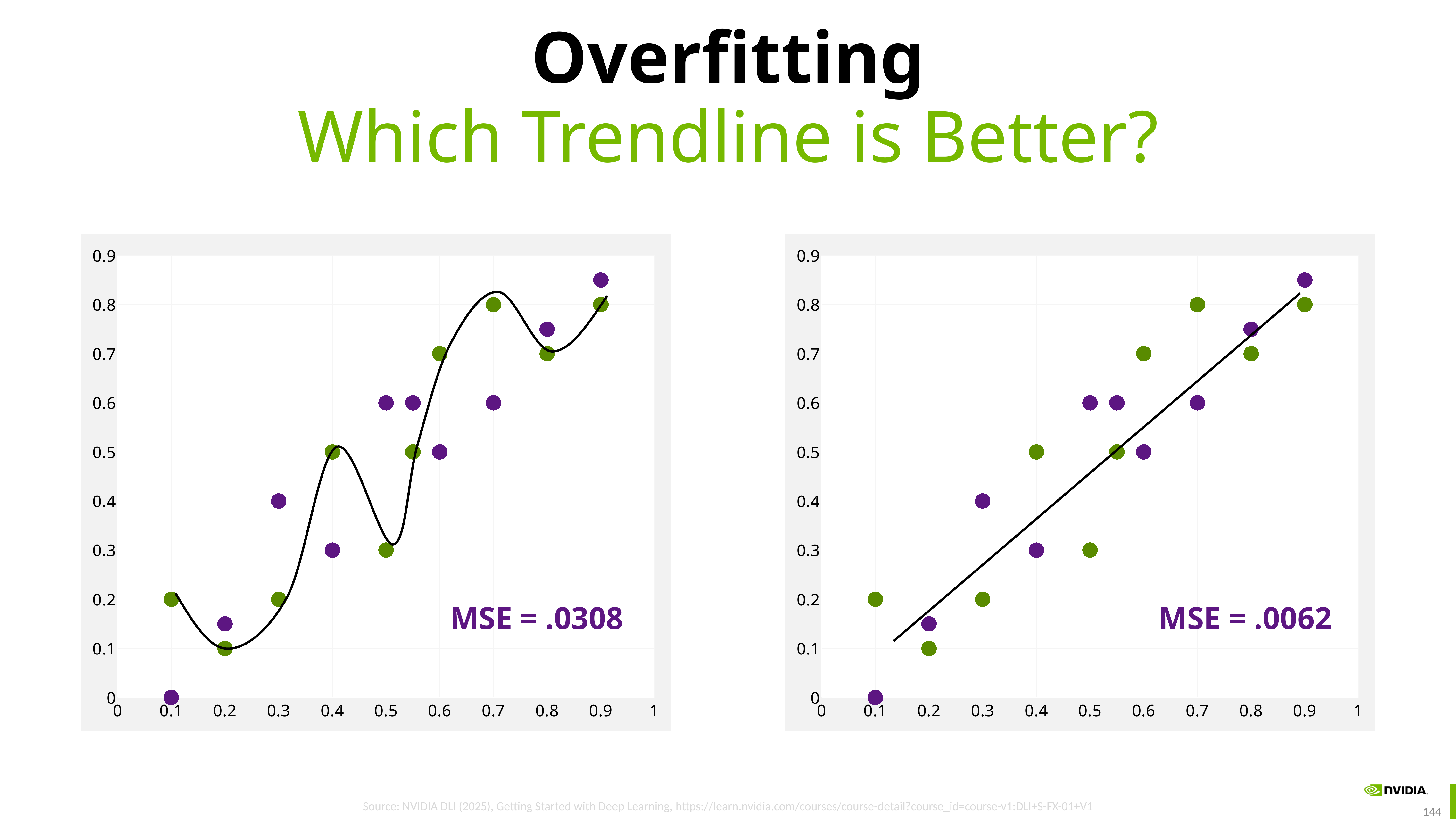
On the right chart, what MSE value is printed? MSE = .0062 Which chart, left or right, uses a straight-line trendline? right On the right chart, what is the y value of the green point at x = 0.7? 0.8 What kind of chart is shown on the left of the slide? scatter chart On the right chart, how many green points are plotted? 10 On the left chart, at which x value is the highest purple point located? 0.9 On the left chart, what is the y value of the purple point at x = 0.1? 0 On the left chart, what MSE value is printed? MSE = .0308 On the right chart, does the trendline rise or fall as x increases? rise Which chart, left or right, shows the lower MSE? right On the right chart, is the y value of the purple point at x = 0.9 greater or less than 0.8? greater On the left chart, what is the y value of the green point at x = 0.1? 0.2